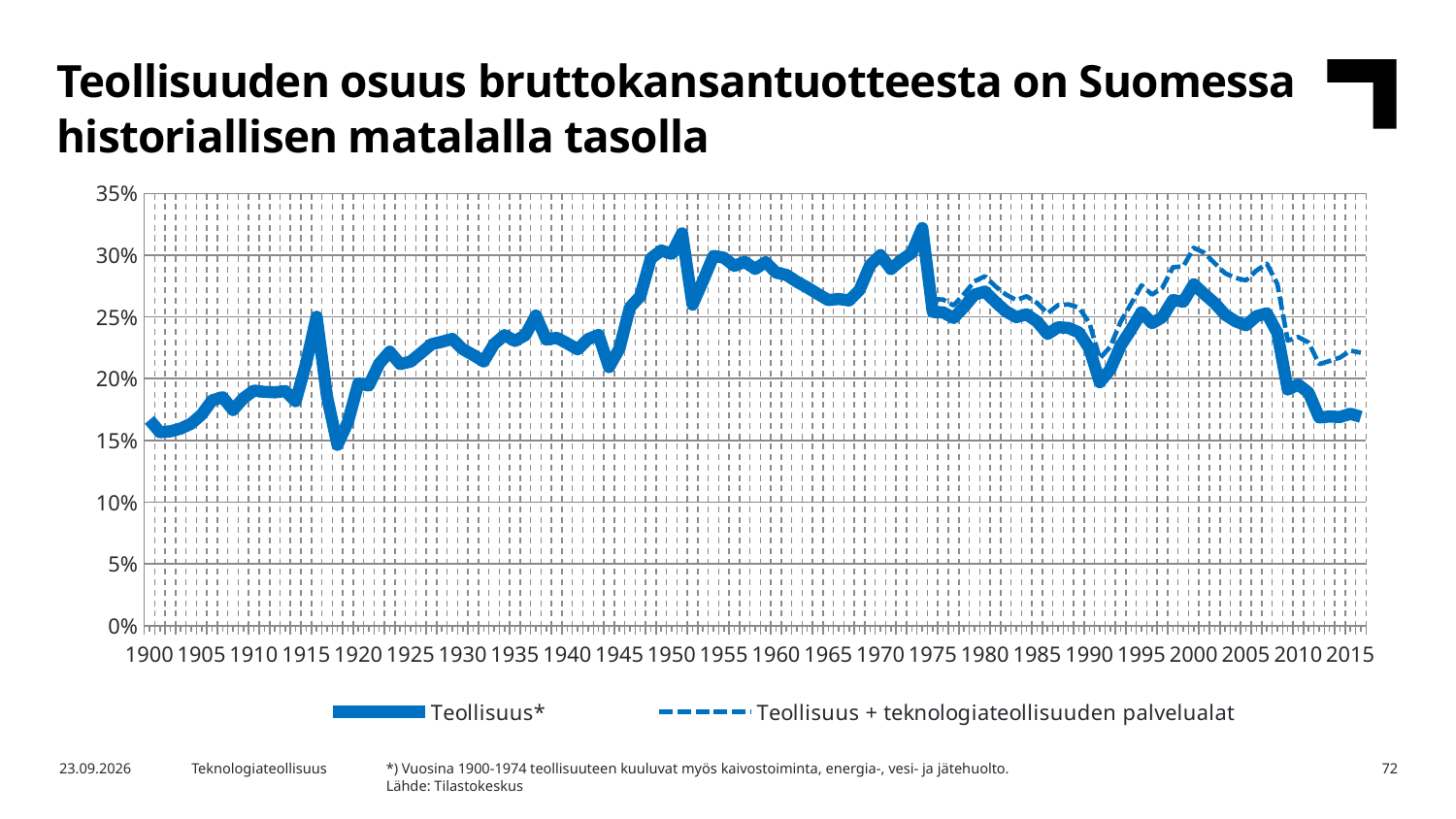
Is the value of Teollisuus* in 2015 greater or less than 20%? less Is the value of Teollisuus* in 1900 greater or less than 20%? less Does the Teollisuus* series rise or fall between 2000 and 2015? fall How many series does the legend list? 2 Which series is drawn with a dashed line? Teollisuus + teknologiateollisuuden palvelualat Which is larger for Teollisuus*: the value in 1950 or the value in 2015? 1950 What is the title of the chart on the slide? Teollisuuden osuus bruttokansantuotteesta on Suomessa historiallisen matalalla tasolla What kind of chart is shown on the slide? line chart Is the value of Teollisuus + teknologiateollisuuden palvelualat in 2015 greater or less than 20%? greater In 2010, which series has the higher value: Teollisuus* or Teollisuus + teknologiateollisuuden palvelualat? Teollisuus + teknologiateollisuuden palvelualat Does the Teollisuus* series rise or fall between 1900 and 1915? rise